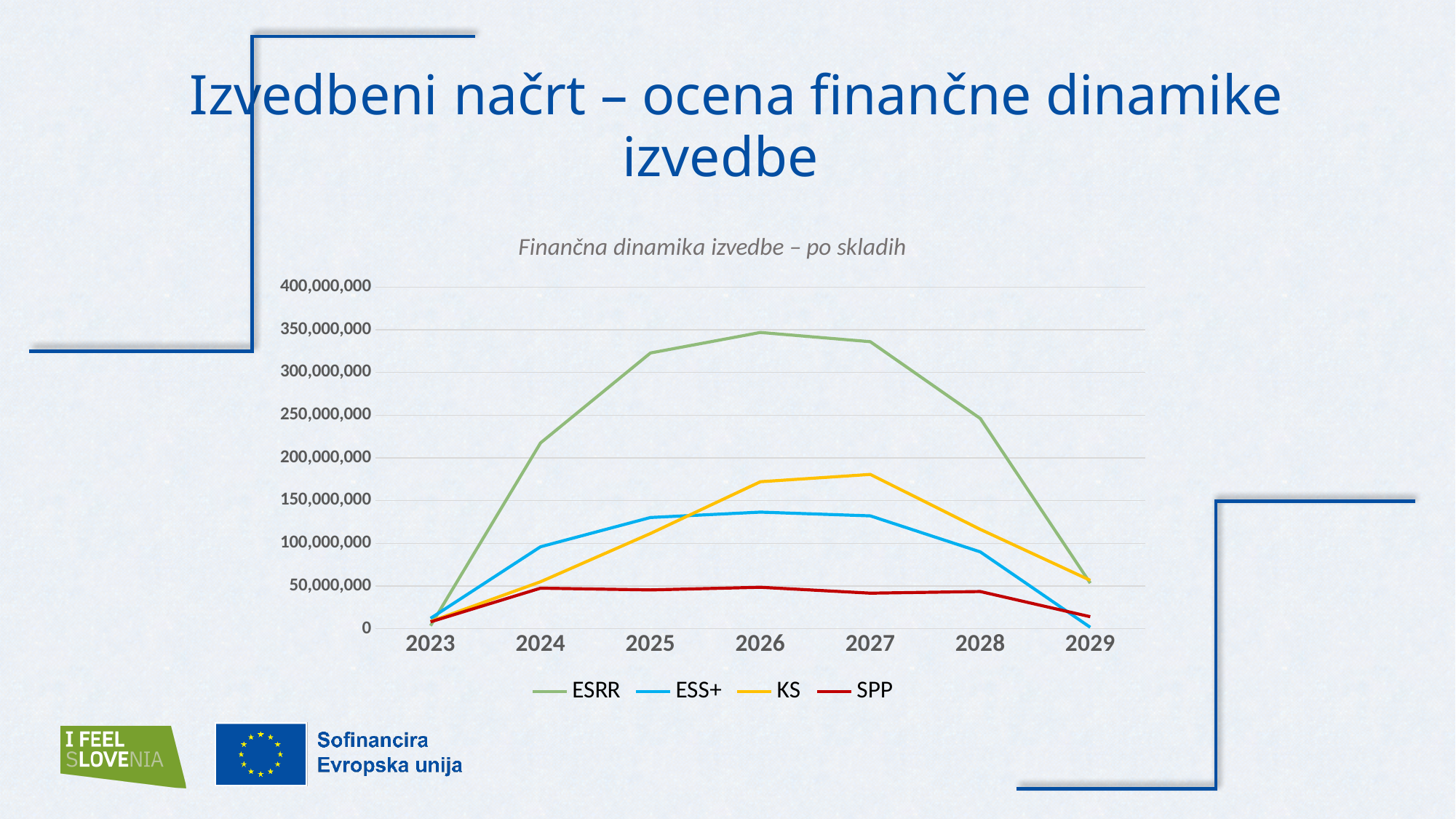
What kind of chart is shown on the slide? line chart Which series has the lowest value in 2026? SPP Does the ESRR series rise or fall from 2026 to 2029? fall How many series does the legend list? 4 Is the value for KS in 2027 greater or less than 150,000,000? greater What is the title of the chart? Finančna dinamika izvedbe – po skladih Which is larger in 2027, the value for KS or the value for ESS+? KS In which year does the ESRR series reach its highest value? 2026 Is the value for ESRR in 2026 greater or less than 300,000,000? greater Is the value for SPP in 2026 greater or less than 100,000,000? less How many years are shown on the x axis? 7 Which series is plotted with the red line? SPP